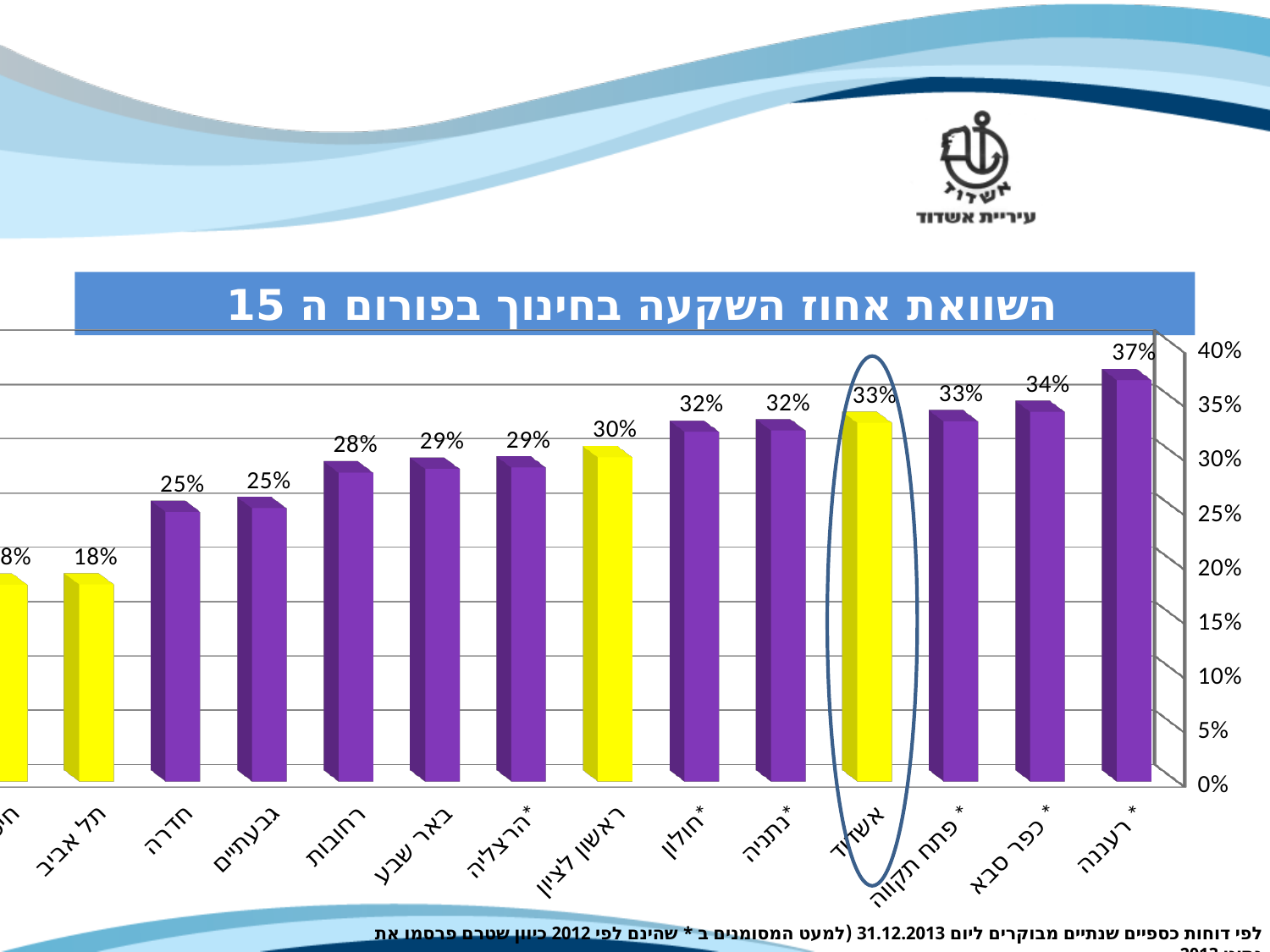
What is the difference between the values for אשדוד and תל אביב? 15% What is the value for תל אביב? 18% What is the value for כפר סבא? 34% What kind of chart is shown on the slide? bar chart Is the value for באר שבע greater or less than 25%? greater What is the value for רעננה? 37% What is the difference between the values for רעננה and אשדוד? 4% What is the value for אשדוד? 33% Which city has the highest value on the chart? רעננה Which is larger, the value for רחובות or the value for חדרה? רחובות What is the value for ראשון לציון? 30% What is the title of the chart? השוואת אחוז השקעה בחינוך בפורום ה 15